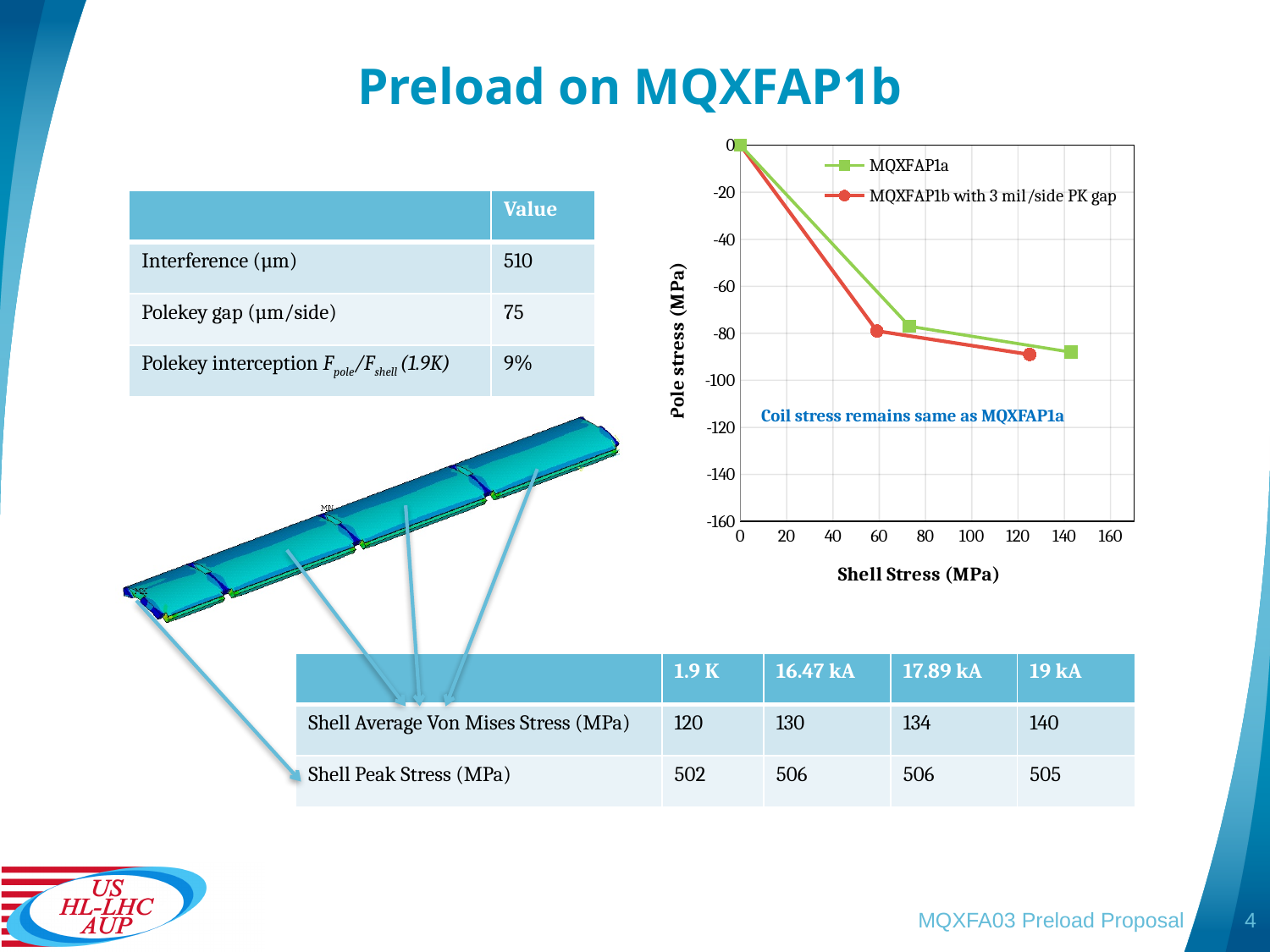
How many data points are plotted for the MQXFAP1a series? 3 Is the shell stress of the middle point of the MQXFAP1b with 3 mil/side PK gap series greater or less than 80? less What is the title of the chart's x axis? Shell Stress (MPa) Is the shell stress of the last MQXFAP1a point greater or less than 120? greater Which series reaches the higher shell stress at its final point, MQXFAP1a or MQXFAP1b with 3 mil/side PK gap? MQXFAP1a Does the pole stress rise or fall as shell stress increases along the x axis? fall How many series does the chart legend list? 2 Is the shell stress of the last point of the MQXFAP1b with 3 mil/side PK gap series greater or less than 140? less What kind of chart is shown on the slide? line chart What are the two series named in the chart legend? MQXFAP1a; MQXFAP1b with 3 mil/side PK gap What is the lowest value shown on the chart's y axis? -160